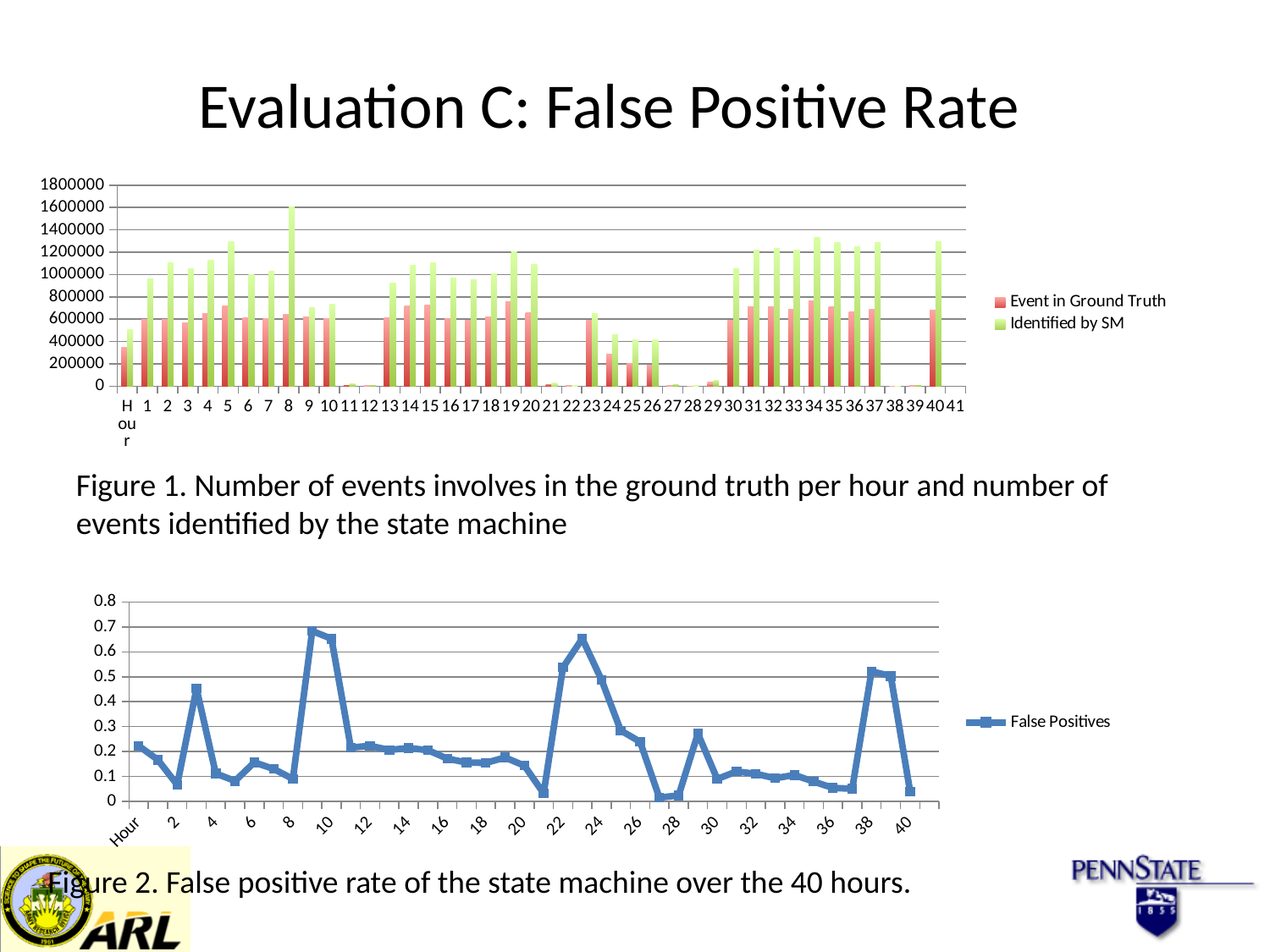
In the bottom chart (Figure 2), which hour has the larger False Positives value, hour 3 or hour 4? hour 3 What kind of chart is the bottom chart (Figure 2)? line chart In the bottom chart (Figure 2), is the False Positives value at hour 9 greater or less than 0.6? greater What series name does the legend of the bottom chart (Figure 2) show? False Positives In the top chart (Figure 1), is the Identified by SM value at hour 12 greater or less than 200000? less In the top chart (Figure 1), is the Identified by SM value at hour 8 greater or less than 1400000? greater In the top chart (Figure 1), at hour 34, which series has the larger value, Event in Ground Truth or Identified by SM? Identified by SM How many series does the legend of the top chart (Figure 1) list? 2 In the bottom chart (Figure 2), do the False Positives values rise or fall from hour 9 to hour 11? fall In the top chart (Figure 1), at which hour is the Identified by SM value highest? 8 What kind of chart is the top chart (Figure 1)? bar chart